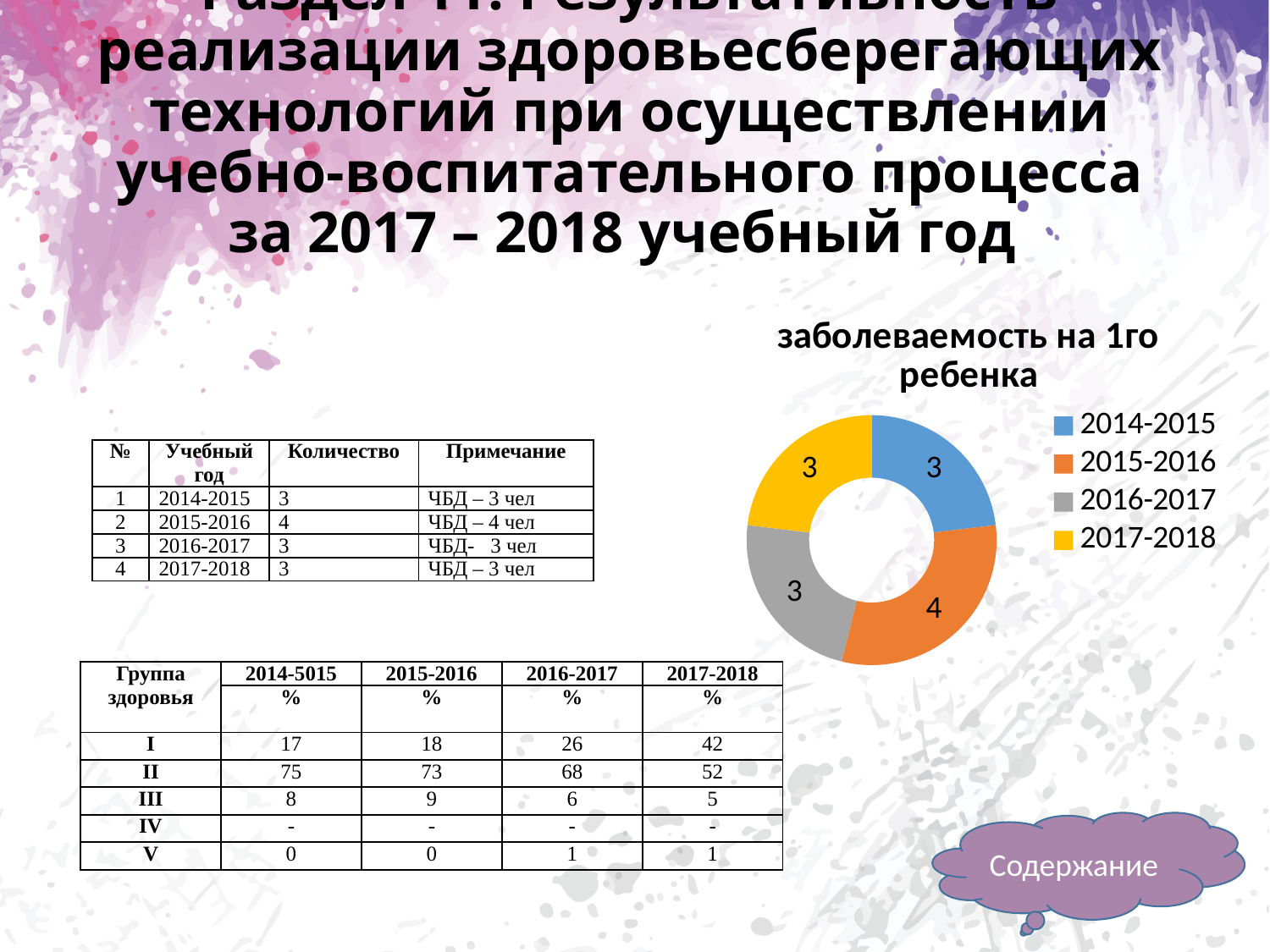
What is the value for 2017-2018 in the doughnut chart? 3 What is the value for 2014-2015 in the doughnut chart? 3 Which year has the highest value in the doughnut chart? 2015-2016 How many categories does the doughnut chart show? 4 Which is larger in the doughnut chart, the value for 2015-2016 or the value for 2017-2018? 2015-2016 How many entries does the legend of the doughnut chart list? 4 What is the difference between the values for 2015-2016 and 2016-2017 in the doughnut chart? 1 What is the value for 2015-2016 in the doughnut chart? 4 What is the title of the doughnut chart? заболеваемость на 1го ребенка What is the total of all values shown in the doughnut chart? 13 Which colour represents 2017-2018 in the doughnut chart? Yellow What type of chart is shown on the slide? Doughnut chart